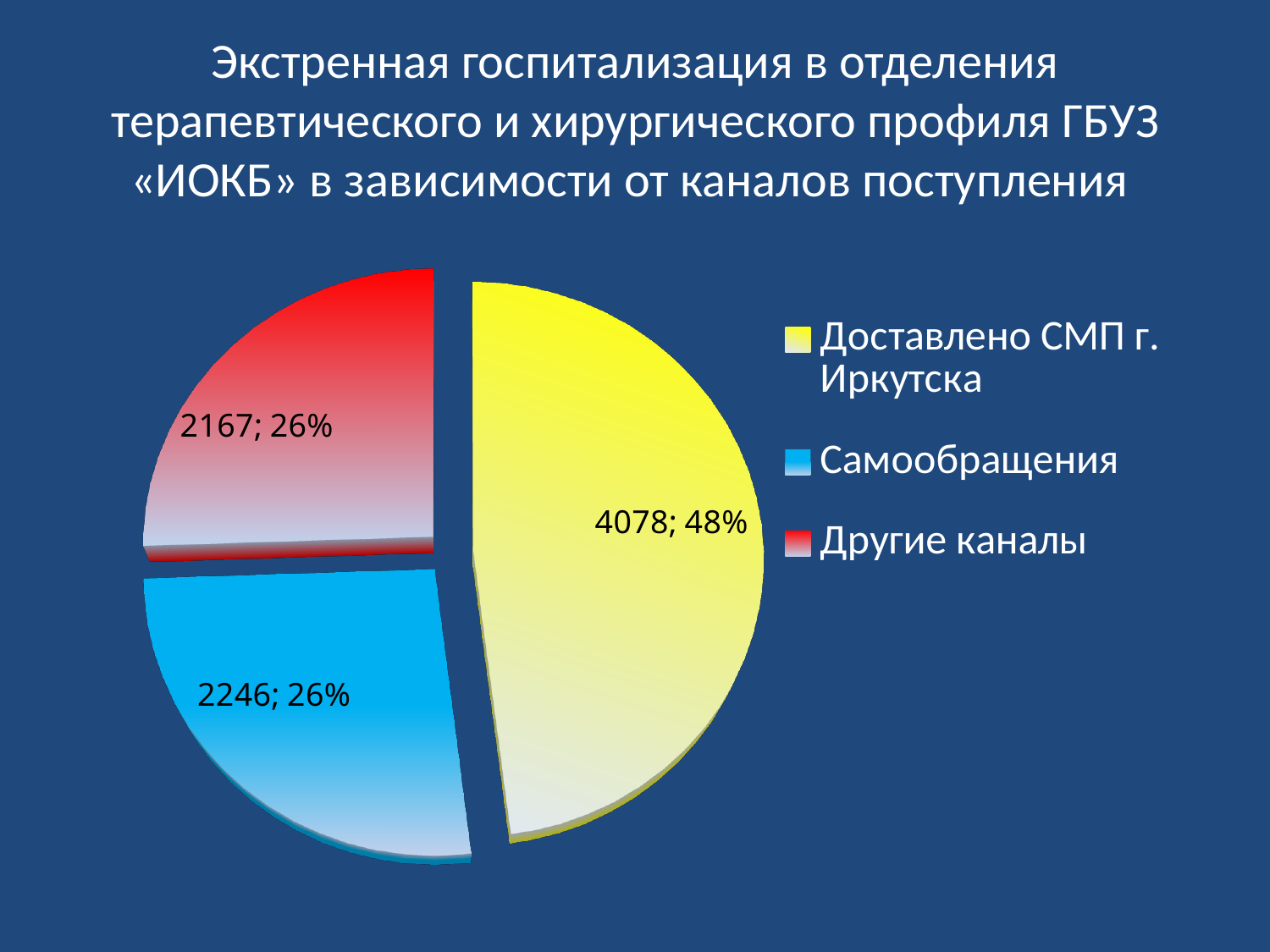
What share of the pie does Доставлено СМП г. Иркутска represent? 48% What share of the pie does Другие каналы represent? 26% What is the value for Самообращения? 2246 What is the value for Доставлено СМП г. Иркутска? 4078 What is the value for Другие каналы? 2167 How many entries does the legend list? 3 What is the difference between the values for Самообращения and Другие каналы? 79 Which category has the largest slice? Доставлено СМП г. Иркутска Which colour represents Самообращения in the pie chart? blue Which category has the smallest value? Другие каналы What kind of chart is shown on the slide? pie chart How many slices does the pie chart have? 3